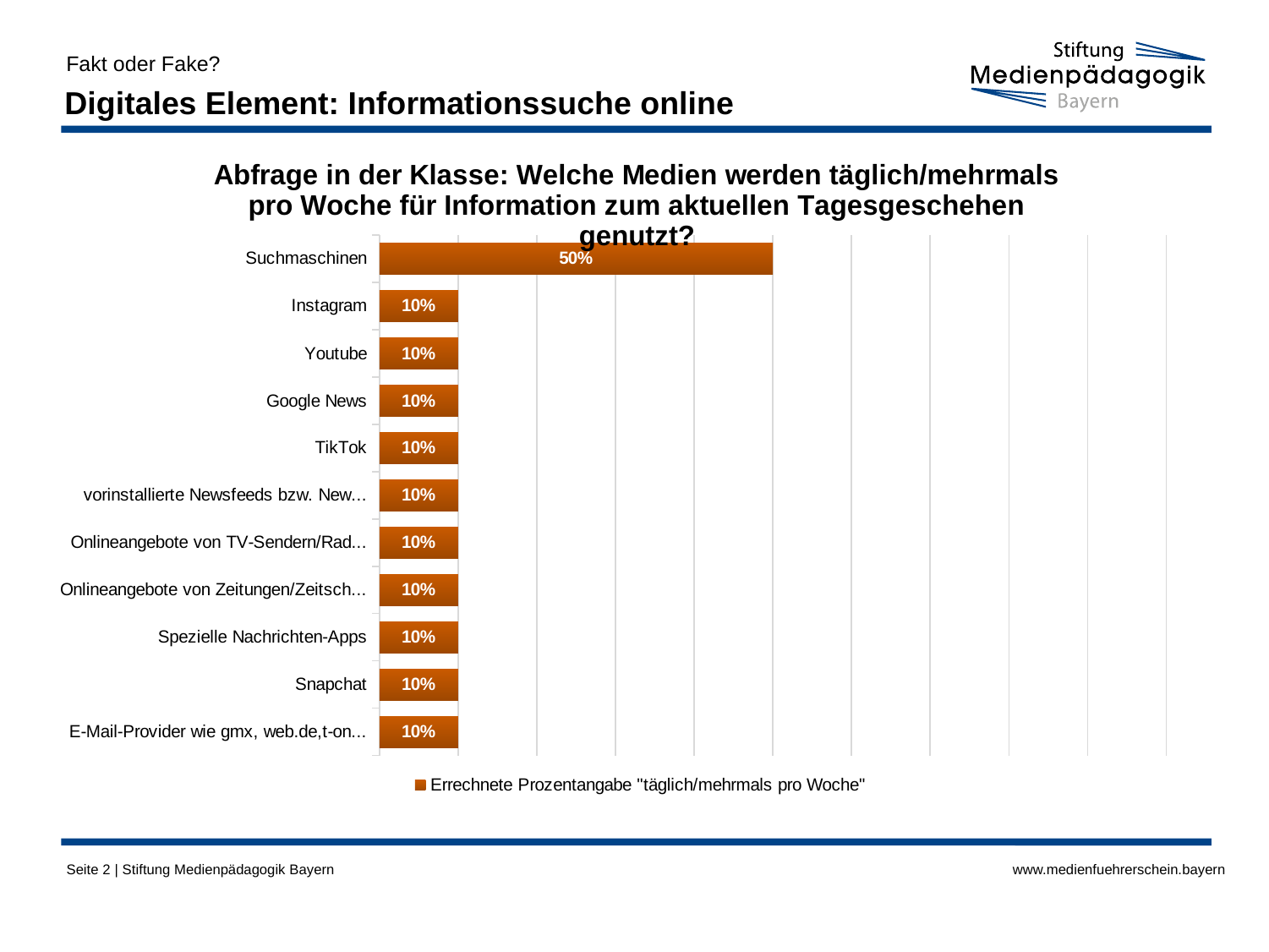
What is the value for TikTok? 10% What is the legend entry of the chart? Errechnete Prozentangabe "täglich/mehrmals pro Woche" What is the value for Suchmaschinen? 50% What kind of chart is shown on the slide? Bar chart How many categories are shown in the chart? 11 What is the value for Snapchat? 10% How many series does the legend list? 1 What is the value for Spezielle Nachrichten-Apps? 10% What is the value for Instagram? 10% Which category has the highest value? Suchmaschinen What is the difference between the values for Suchmaschinen and Youtube? 40% Which is larger, the value for Suchmaschinen or the value for Google News? Suchmaschinen